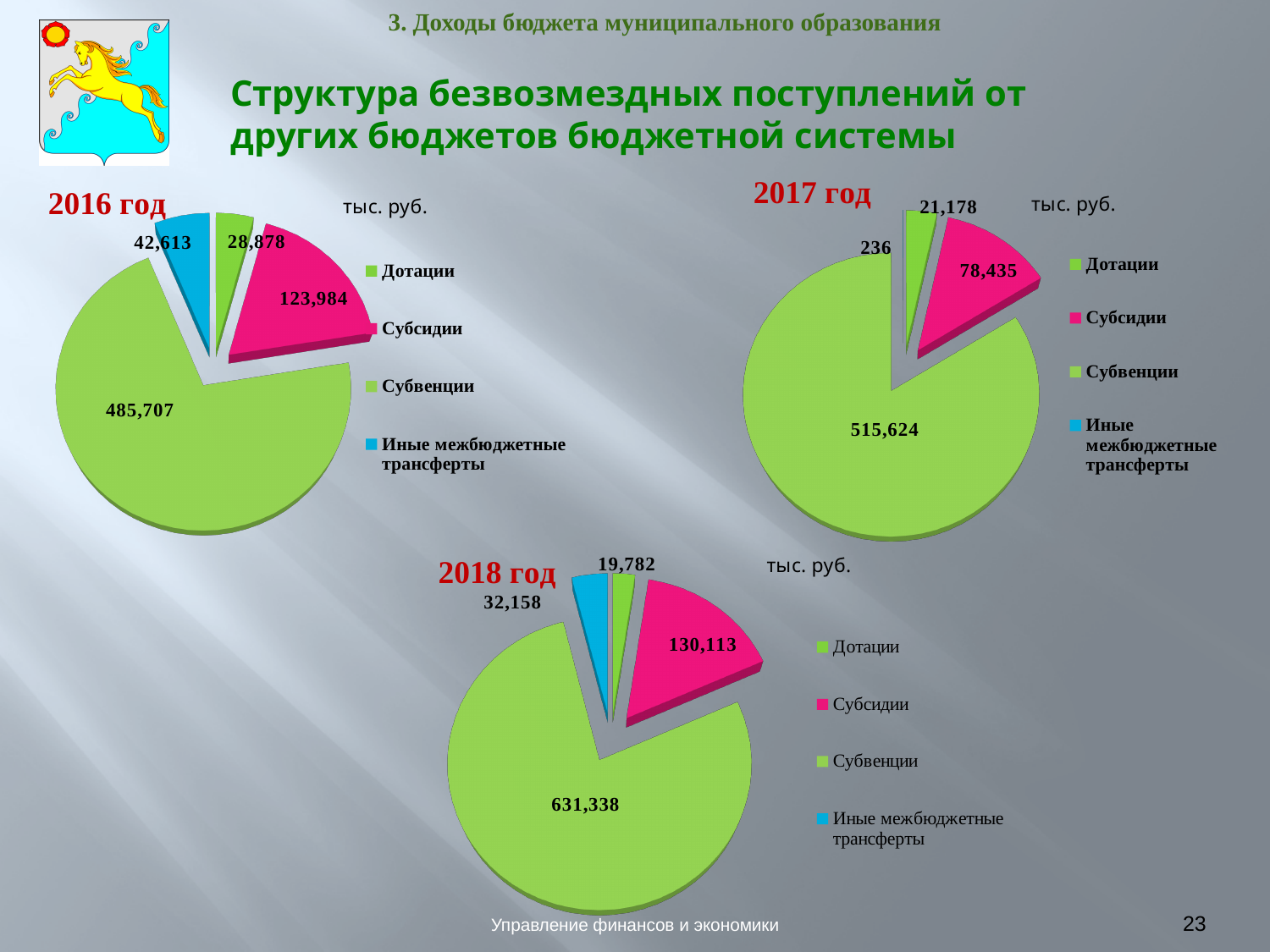
In the 2016 год pie chart, what is the difference between Субсидии and Дотации? 95,106 In the 2018 год pie chart, what is the value for Дотации? 19,782 In the 2016 год pie chart, what is the value for Субвенции? 485,707 How many categories does the legend of the 2016 год pie chart list? 4 In the 2017 год pie chart, what is the value for Субсидии? 78,435 In the 2018 год pie chart, what colour is the Субсидии slice? Pink What type of chart is used for the 2017 год data? Pie chart In the 2018 год pie chart, which category has the largest slice? Субвенции In the 2016 год pie chart, what is the value for Иные межбюджетные трансферты? 42,613 In the 2018 год pie chart, which is larger: Субсидии or Иные межбюджетные трансферты? Субсидии In the 2017 год pie chart, which category has the smallest slice? Иные межбюджетные трансферты In the 2017 год pie chart, what is the value for Иные межбюджетные трансферты? 236